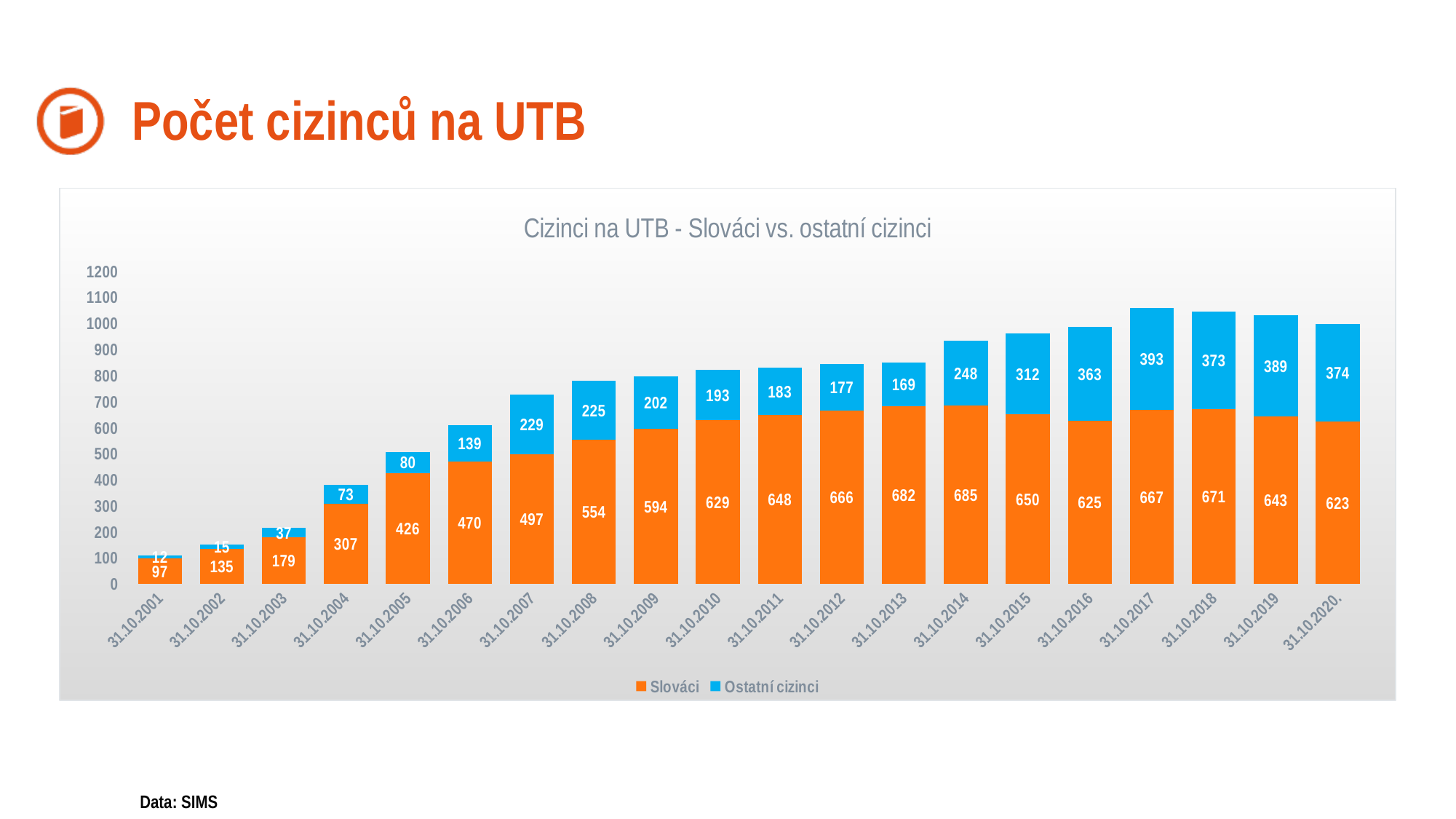
What is the value for Slováci on 31.10.2014? 685 What is the value for Ostatní cizinci on 31.10.2017? 393 Which is larger: Ostatní cizinci on 31.10.2016 or on 31.10.2018? 31.10.2018 What type of chart is shown? Stacked bar chart What is the difference between the Slováci values on 31.10.2014 and 31.10.2020.? 62 What is the total of the stacked bar for 31.10.2017? 1060 How many dates are shown on the x axis? 20 How many series does the legend list? 2 What is the total of the stacked bar for 31.10.2001? 109 In which year is the Slováci value the lowest? 31.10.2001 In which year does the Ostatní cizinci series reach its highest value? 31.10.2017 What is the value for Slováci on 31.10.2001? 97